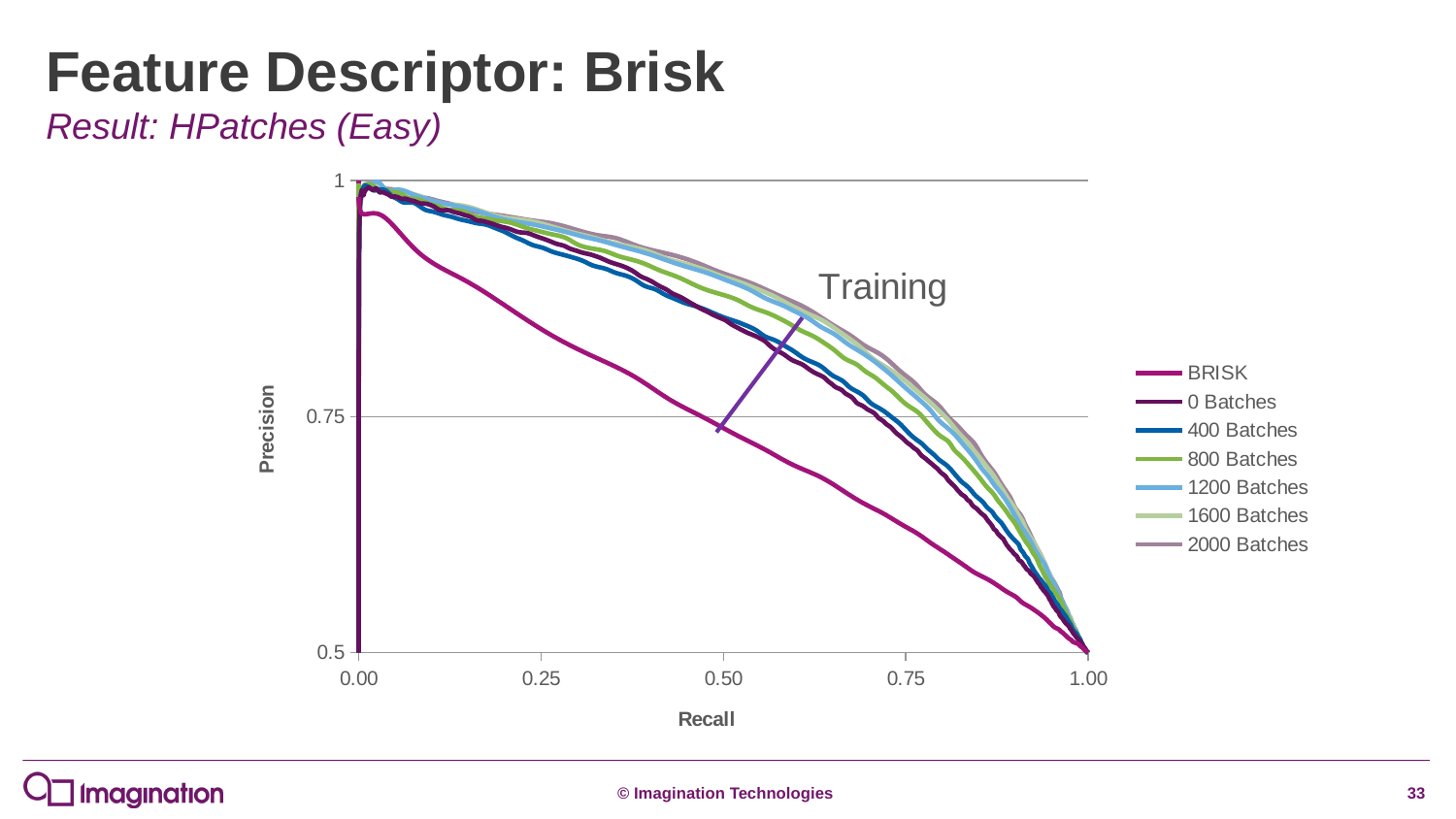
At a recall of 0.75, which series has the higher precision, 0 Batches or 1200 Batches? 1200 Batches How many series does the legend list? 7 What is the label of the x axis? Recall Which series has the lowest precision across most of the recall range? BRISK What is the label of the y axis? Precision At a recall of 0.25, is the precision of the 0 Batches series greater or less than 0.75? greater Does precision rise or fall as recall increases along the x axis? fall At a recall of 0.75, is the precision of the BRISK series greater or less than 0.75? less What kind of chart is shown on the slide? line chart At a recall of 0.50, which series has the higher precision, BRISK or 2000 Batches? 2000 Batches What precision value do all the series converge to at a recall of 1.00? 0.5 At a recall of 0.50, is the precision of the 2000 Batches series greater or less than 0.75? greater